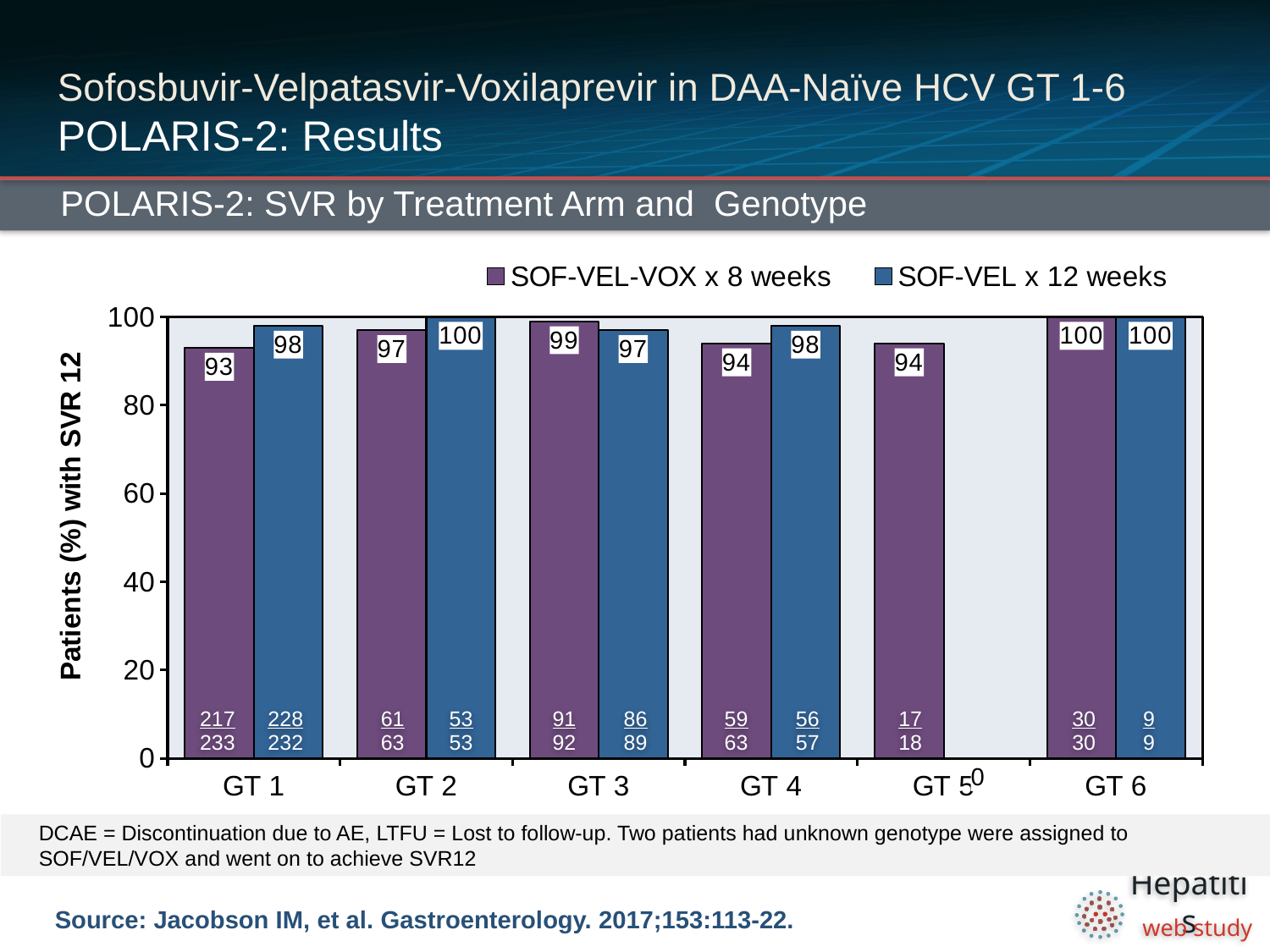
What is the SVR12 rate for SOF-VEL x 12 weeks in GT 4? 98 What is the difference between the SOF-VEL x 12 weeks and SOF-VEL-VOX x 8 weeks SVR12 rates in GT 1? 5 In GT 3, which treatment arm has the higher SVR12 rate? SOF-VEL-VOX x 8 weeks What is the SVR12 rate for SOF-VEL-VOX x 8 weeks in GT 3? 99 Which genotype has the lowest SVR12 rate for SOF-VEL-VOX x 8 weeks? GT 1 What is the SVR12 rate for SOF-VEL x 12 weeks in GT 2? 100 How many genotype categories are shown on the x axis? 6 How many series does the legend list? 2 What is the SVR12 rate for SOF-VEL-VOX x 8 weeks in GT 1? 93 How many patients achieved SVR12 out of how many treated with SOF-VEL-VOX x 8 weeks in GT 5? 17/18 Which genotype has only one treatment arm plotted? GT 5 What kind of chart is shown on the slide? Bar chart